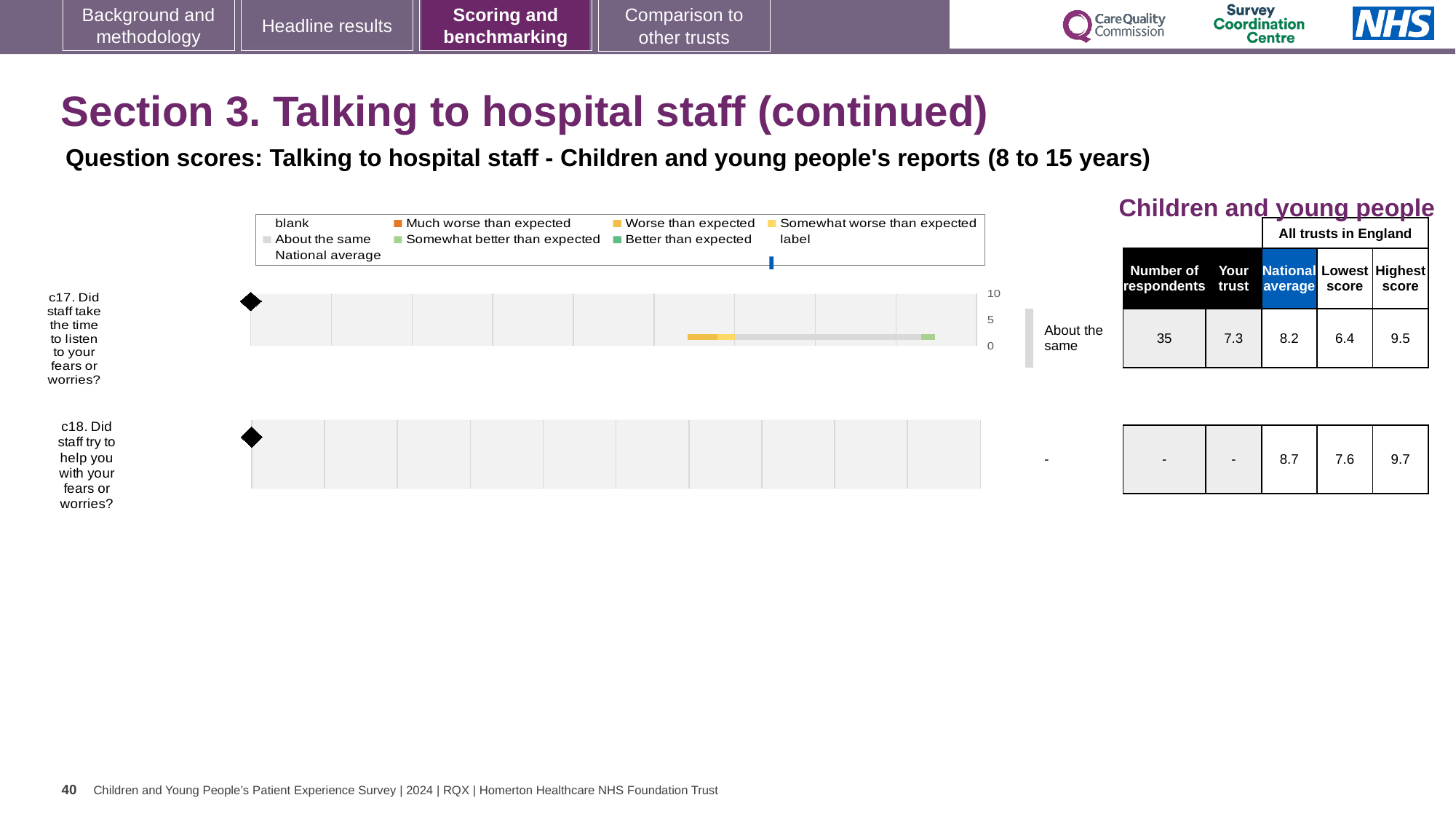
Which question has the higher national average, c17 or c18? c18 How many survey questions are plotted on the chart? 2 How many respondents answered question c17? 35 What is the 'Your trust' score for question c17 (Did staff take the time to listen to your fears or worries?)? 7.3 What is the highest score across all trusts in England for question c18 (Did staff try to help you with your fears or worries?)? 9.7 What is the national average score for question c17? 8.2 What is the lowest score across all trusts in England for question c17? 6.4 For question c17, how much higher is the national average than the trust's score? 0.9 For question c17, what is the difference between the highest and lowest scores across all trusts in England? 3.1 What benchmark category is shown for question c17? About the same What kind of chart is used to show the question scores? Bar chart For question c17, which is higher: the trust's score or the national average? National average